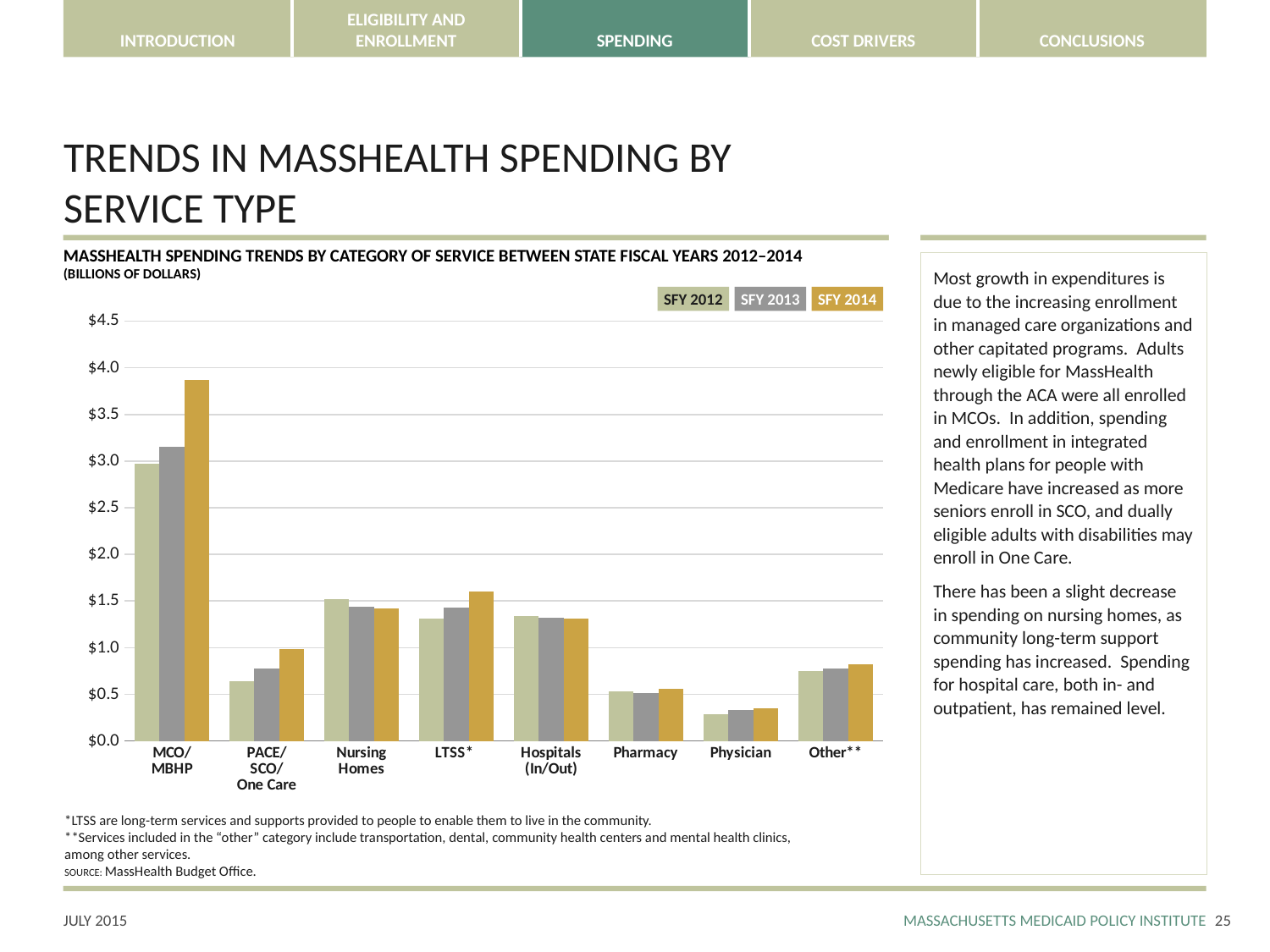
Which service category has the highest SFY 2014 spending? MCO/MBHP Does MCO/MBHP spending rise or fall from SFY 2012 to SFY 2014? rise Which service category has the lowest SFY 2012 spending? Physician In SFY 2014, which is larger: spending on LTSS* or on Nursing Homes? LTSS* Is the SFY 2014 value for Other** greater or less than $1.0? less How many service categories are shown on the x axis? 8 How many series does the legend list? 3 Is the SFY 2012 value for Physician greater or less than $0.5? less What kind of chart is shown on the slide? bar chart What are the three legend entries of the chart? SFY 2012, SFY 2013, SFY 2014 Does Nursing Homes spending rise or fall from SFY 2012 to SFY 2014? fall Is the SFY 2014 value for MCO/MBHP greater or less than $3.5? greater